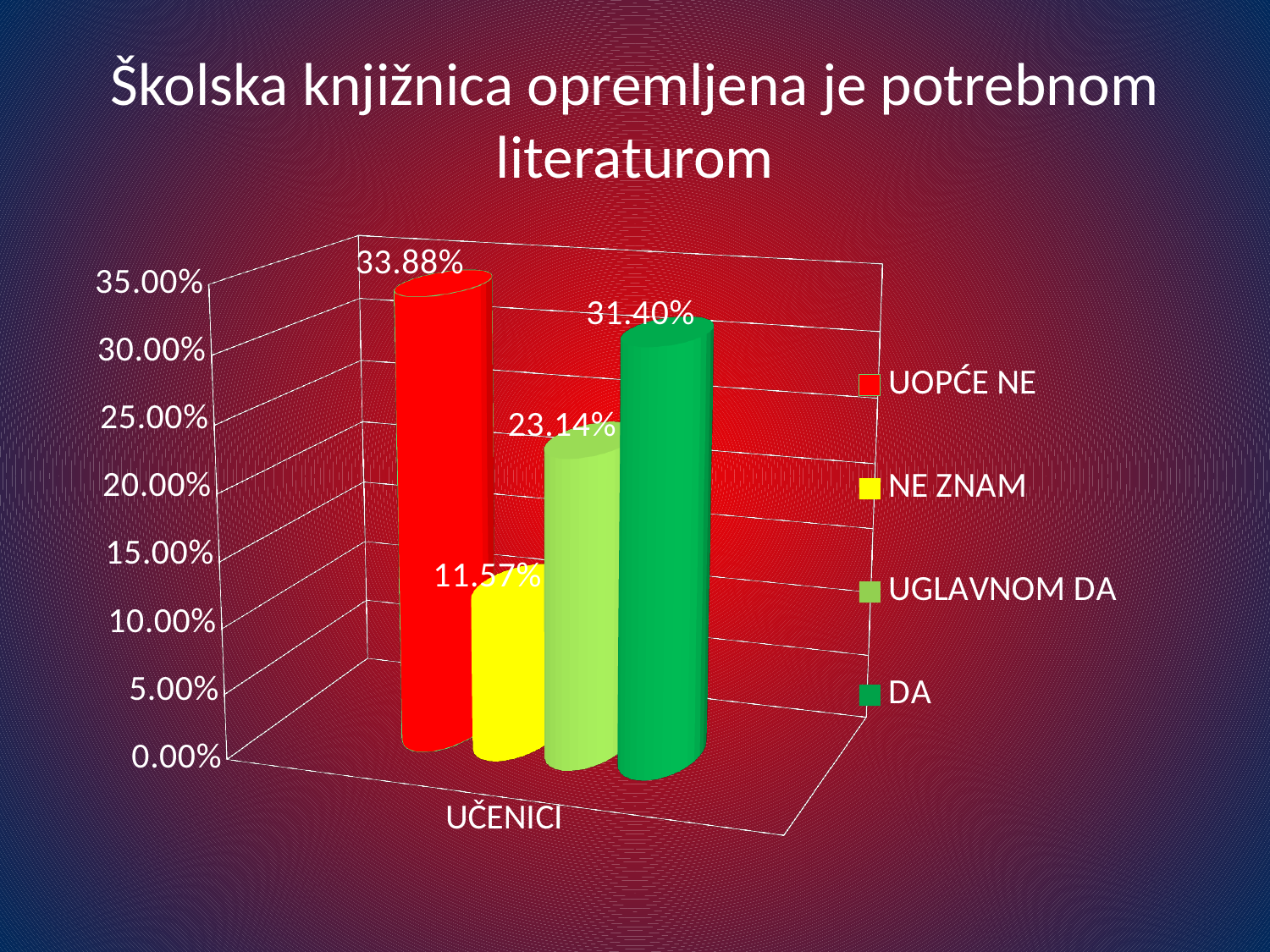
Which series has the lowest value? NE ZNAM Which is larger, the value for UGLAVNOM DA or the value for NE ZNAM? UGLAVNOM DA What is the value for DA? 31.40% How many series does the legend list? 4 What is the value for UGLAVNOM DA? 23.14% What is the category label on the x axis? UČENICI What is the value for UOPĆE NE? 33.88% What kind of chart is shown on the slide? bar chart What is the difference between the values for UOPĆE NE and DA? 2.48% What is the value for NE ZNAM? 11.57% Is the value for DA greater or less than 30.00%? greater Which series has the highest value? UOPĆE NE